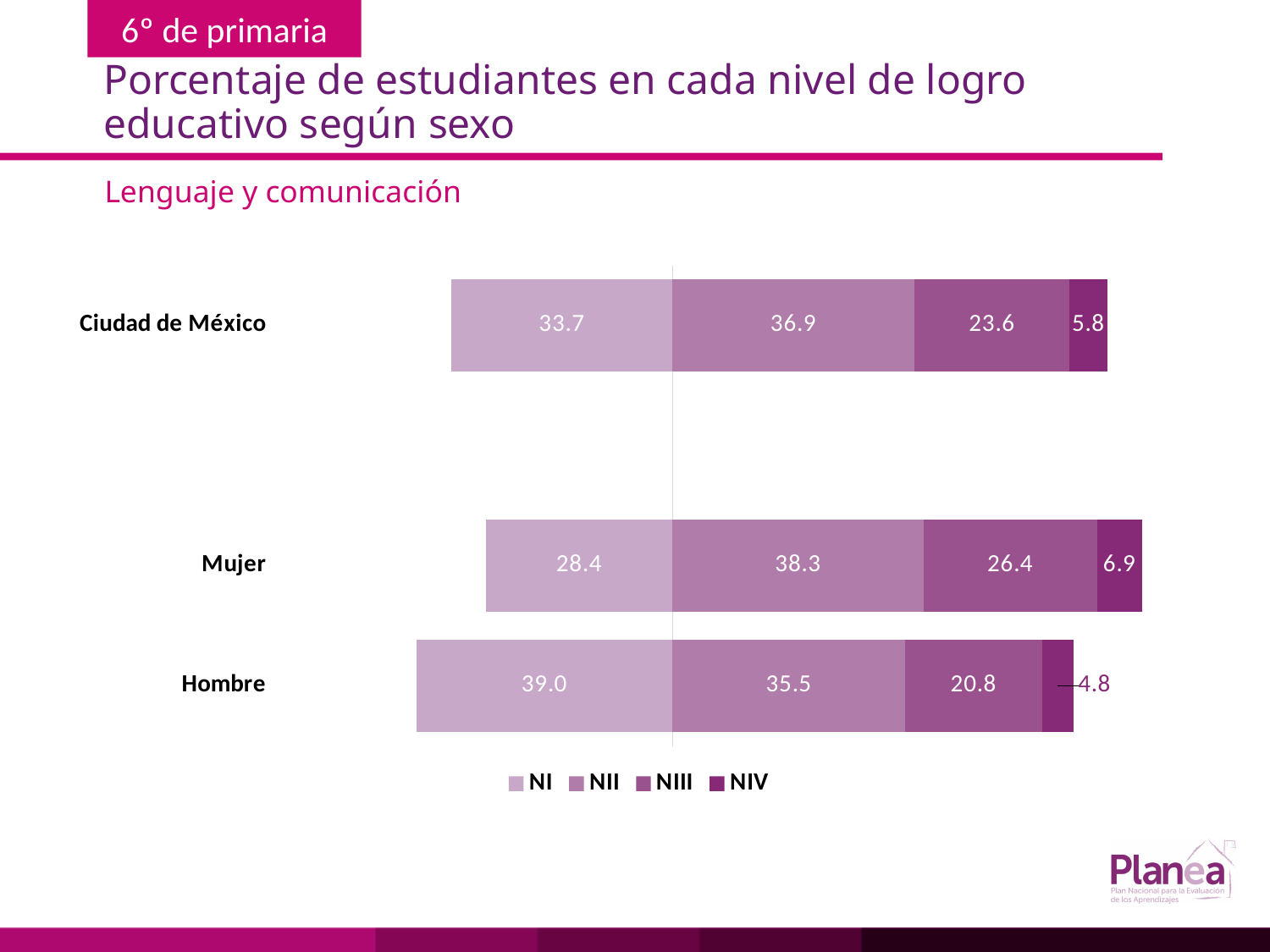
What is the NIV value for Mujer? 6.9 How many series does the legend list? 4 How many categories are shown in the chart? 3 What type of chart is shown on the slide? Stacked bar chart Which category has the lowest NIV value? Hombre What subject area is named above the chart? Lenguaje y comunicación What is the NII value for Ciudad de México? 36.9 What is the difference between the NIII values for Mujer and Hombre? 5.6 Which category has the highest NI value? Hombre What is the NIII value for Hombre? 20.8 What is the NI value for Hombre? 39.0 Which is larger, the NII value for Mujer or the NII value for Hombre? Mujer